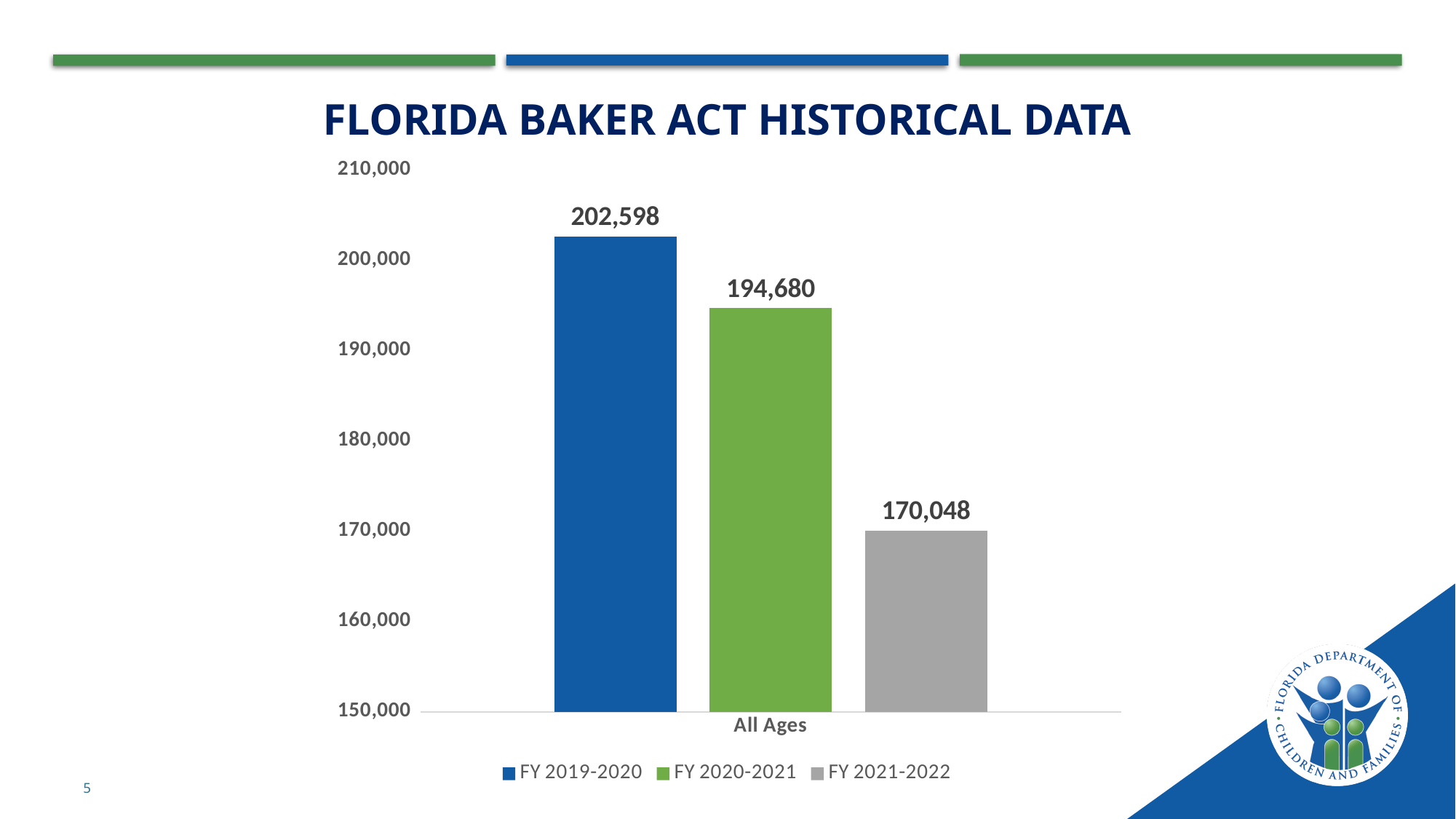
What is the value for FY 2021-2022? 170,048 What is the difference between the FY 2019-2020 and FY 2021-2022 values? 32,550 What kind of chart is shown on the slide? Bar chart What is the value for FY 2020-2021? 194,680 Which fiscal year has the highest value? FY 2019-2020 Which fiscal year has the lowest value? FY 2021-2022 What is the difference between the FY 2019-2020 and FY 2020-2021 values? 7,918 What is the value for FY 2019-2020? 202,598 What is the title of the chart? FLORIDA BAKER ACT HISTORICAL DATA How many series does the legend list? 3 Which is larger, the value for FY 2020-2021 or FY 2021-2022? FY 2020-2021 Is the value for FY 2020-2021 greater or less than 190,000? greater